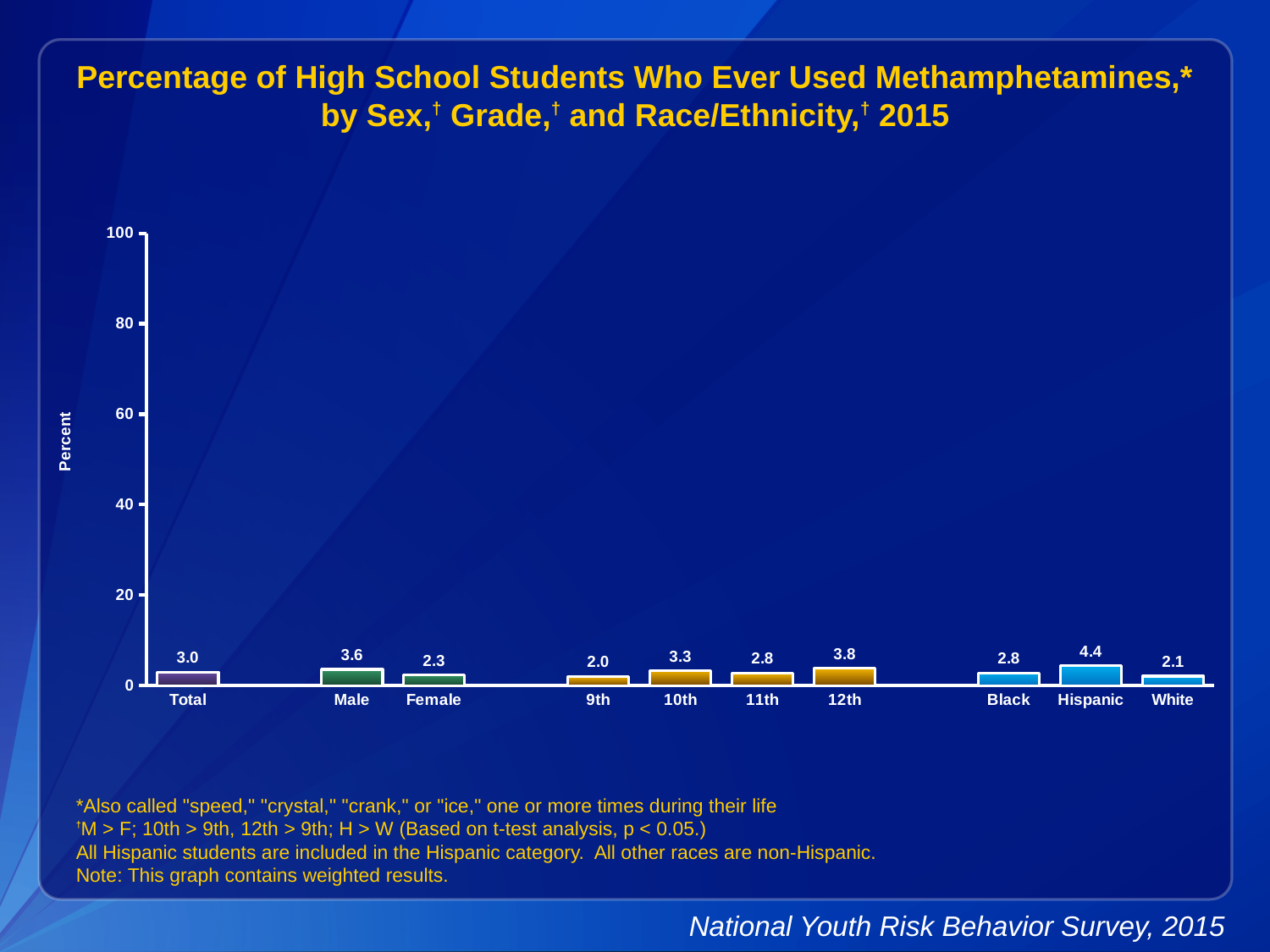
Which category has the highest value? Hispanic What is the difference between the Male and Female values? 1.3 Do the values rise or fall from 9th grade to 10th grade? rise What is the value for Total? 3.0 How many categories are shown on the x axis? 10 What kind of chart is this? bar chart Is the value for White students greater or less than 20? less Which category has the lowest value? 9th Which is larger, the value for 12th grade or the value for 10th grade? 12th What is the label on the y axis? Percent What is the value for 9th grade? 2.0 What is the value for Hispanic students? 4.4